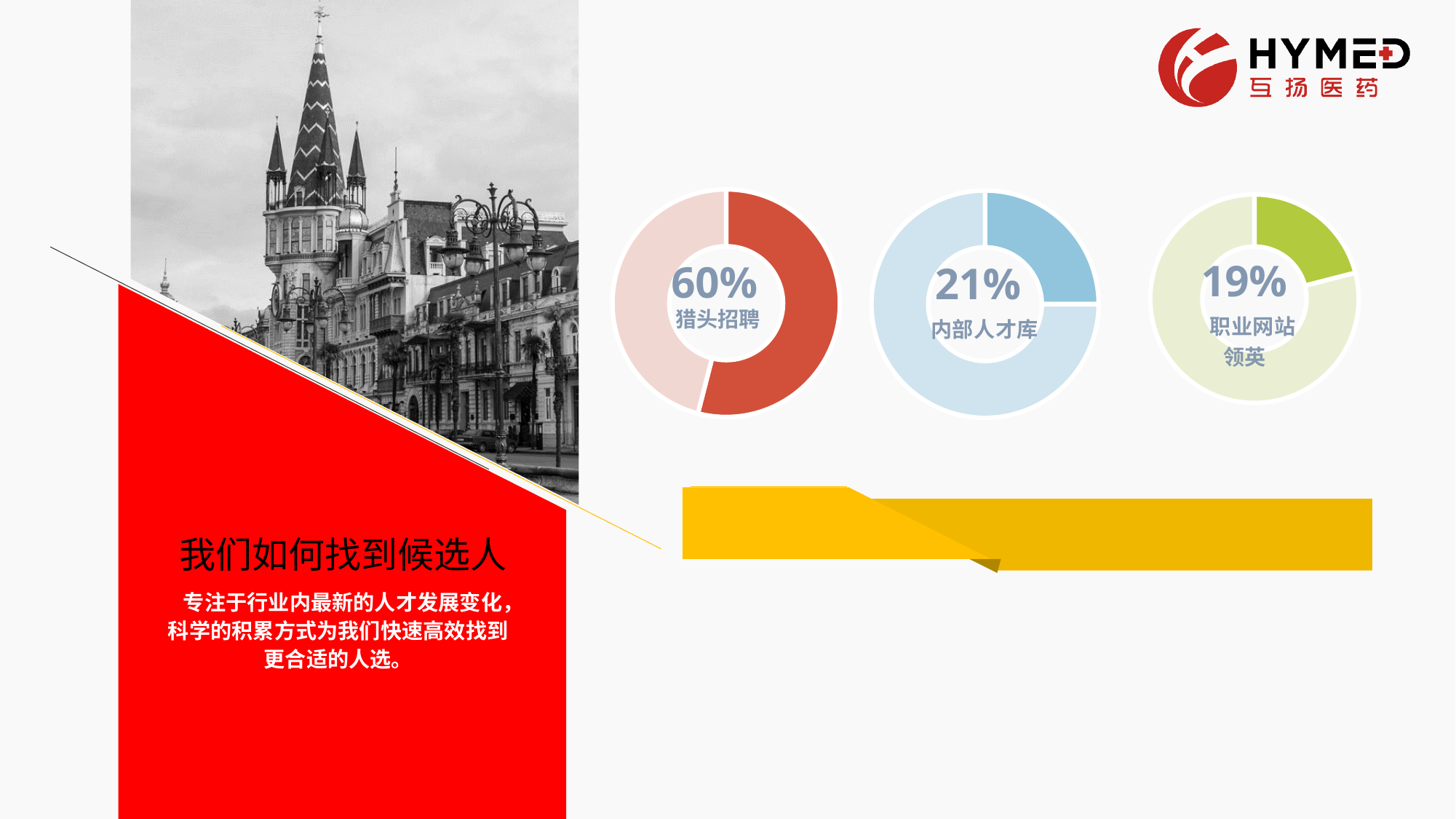
What percentage is shown in the donut chart labelled 内部人才库? 21% How many donut charts are shown on the slide? 3 What is the difference in percentage points between 内部人才库 and 职业网站领英? 2 Which of the three candidate sources has the lowest percentage? 职业网站领英 Which of the three candidate sources has the highest percentage? 猎头招聘 What colour is the highlighted slice in the 职业网站领英 donut chart? Green What percentage is shown in the donut chart labelled 职业网站领英? 19% Which is larger, the percentage for 猎头招聘 or the percentage for 职业网站领英? 猎头招聘 What kind of chart is used to show each percentage on the slide? Donut (pie) chart What percentage is shown in the donut chart labelled 猎头招聘? 60% What colour is the highlighted slice in the 内部人才库 donut chart? Blue What is the difference in percentage points between 猎头招聘 and 内部人才库? 39